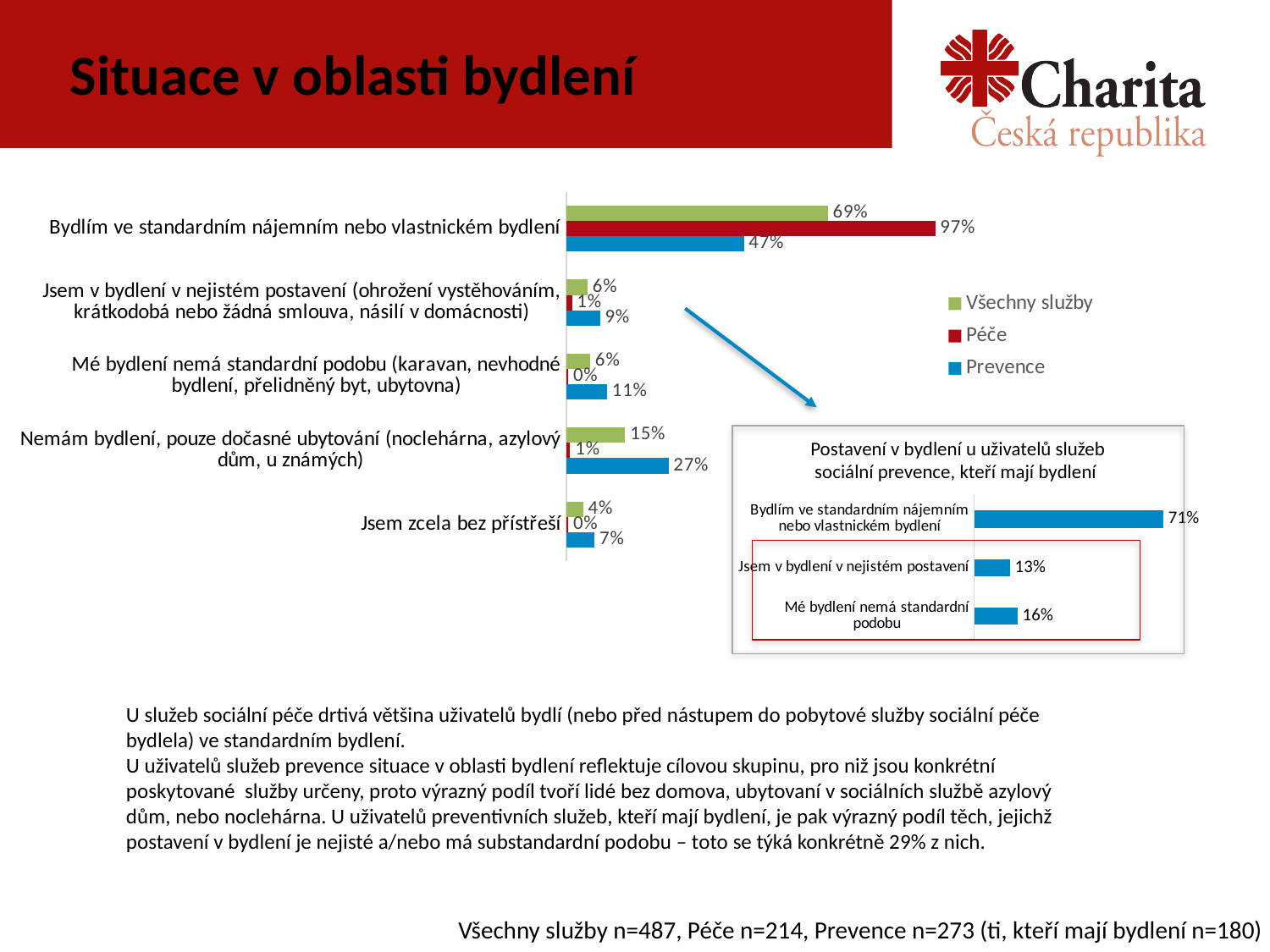
How many series does the legend of the main chart on the left list? 3 In the main chart on the left, which is larger for 'Mé bydlení nemá standardní podobu (karavan, nevhodné bydlení, přelidněný byt, ubytovna)': the Všechny služby value or the Prevence value? Prevence In the main chart on the left, what is the difference between the Péče and Prevence values for 'Bydlím ve standardním nájemním nebo vlastnickém bydlení'? 50% In the inset chart 'Postavení v bydlení u uživatelů služeb sociální prevence, kteří mají bydlení', which category has the lowest value? Jsem v bydlení v nejistém postavení What kind of chart is the main chart on the left? Bar chart In the inset chart 'Postavení v bydlení u uživatelů služeb sociální prevence, kteří mají bydlení', what is the value for 'Jsem v bydlení v nejistém postavení'? 13% In the main chart on the left, what is the Všechny služby value for 'Jsem zcela bez přístřeší'? 4% In the main chart on the left, what is the Prevence value for 'Nemám bydlení, pouze dočasné ubytování (noclehárna, azylový dům, u známých)'? 27% In the inset chart 'Postavení v bydlení u uživatelů služeb sociální prevence, kteří mají bydlení', what is the difference between the values for 'Bydlím ve standardním nájemním nebo vlastnickém bydlení' and 'Mé bydlení nemá standardní podobu'? 55% How many categories does the main chart on the left show? 5 In the main chart on the left, which category has the highest Prevence value? Bydlím ve standardním nájemním nebo vlastnickém bydlení In the main chart on the left, what is the Péče value for 'Bydlím ve standardním nájemním nebo vlastnickém bydlení'? 97%